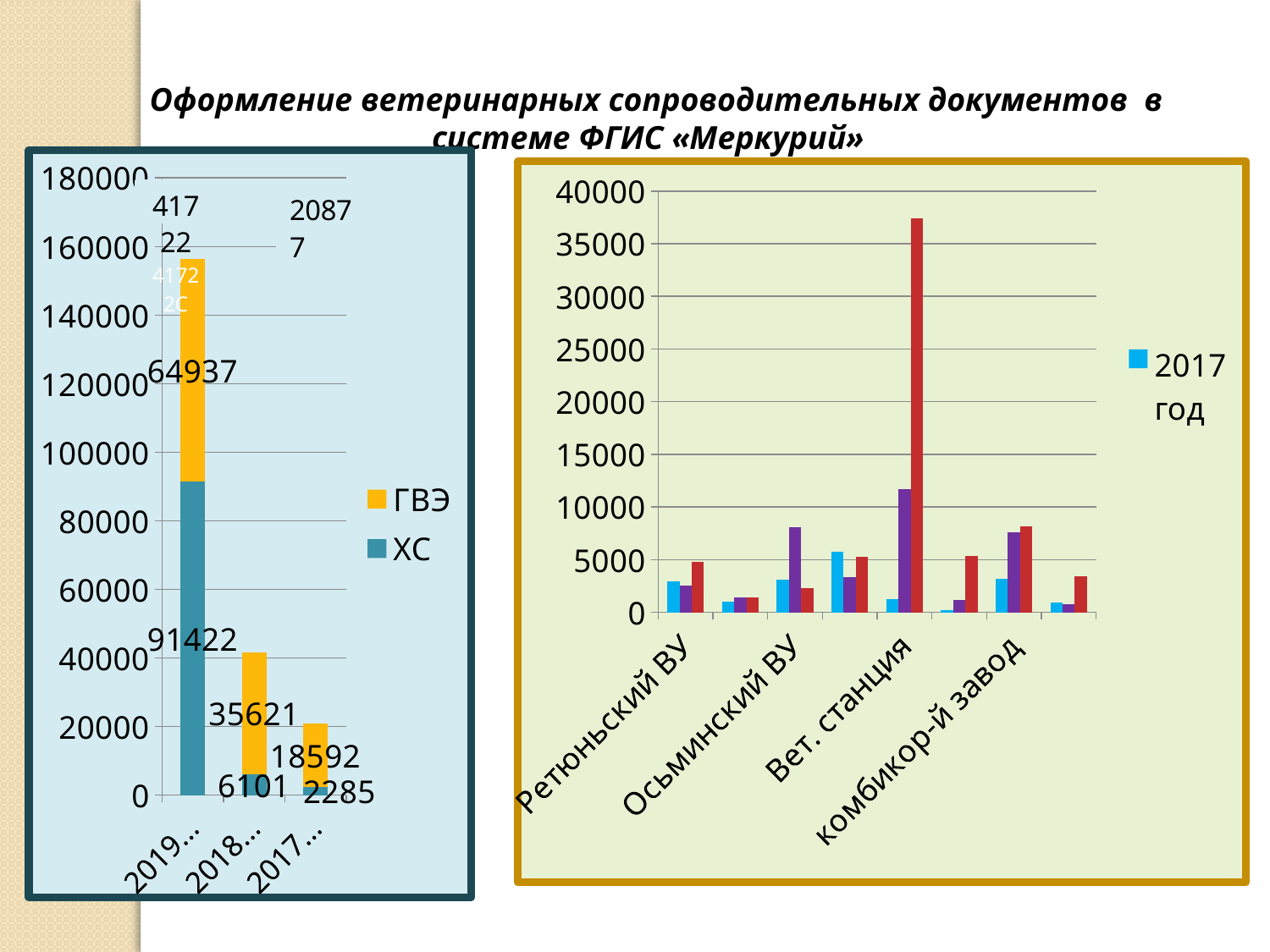
In the left chart, what is the value of ГВЭ for 2018? 35621 In the left chart, what is the value of ГВЭ for 2017? 18592 In the left chart, what is the value of ХС for 2017? 2285 In the left chart, how many series does the legend list? 2 In the right chart, is the value of the red bar for Вет. станция greater or less than 35000? greater In the left chart, do the ГВЭ values rise or fall from left to right along the x axis? fall In the right chart, which category has the tallest bar? Вет. станция In the left chart, what is the value of ХС for 2019? 91422 In the left chart, what is the difference between the ГВЭ values for 2018 and 2017? 17029 What kind of chart is the right chart? bar chart In the left chart, which series is larger for 2019, ГВЭ or ХС? ХС In the left chart, what is the total of the stacked bar for 2018? 41722